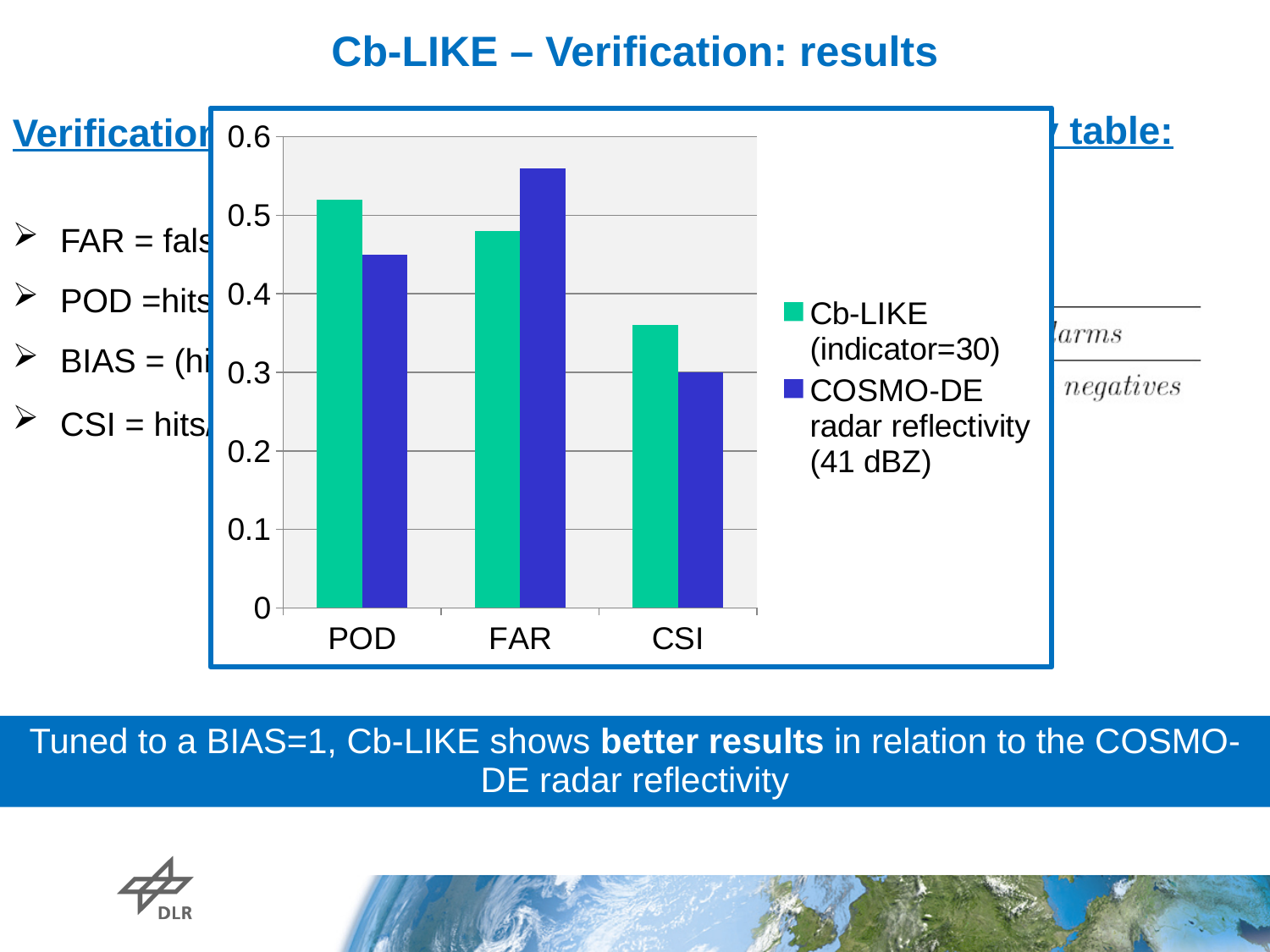
Is the FAR value for COSMO-DE radar reflectivity (41 dBZ) greater or less than 0.5? greater How many series does the chart's legend list? 2 Which series has the larger CSI value, Cb-LIKE (indicator=30) or COSMO-DE radar reflectivity (41 dBZ)? Cb-LIKE (indicator=30) How many categories are shown on the x axis of the chart? 3 Is the CSI value for Cb-LIKE (indicator=30) greater or less than 0.4? less Is the POD value for COSMO-DE radar reflectivity (41 dBZ) greater or less than 0.5? less What kind of chart is shown on the slide? bar chart Which bar is the tallest in the chart? FAR for COSMO-DE radar reflectivity (41 dBZ) Which series has the larger POD value, Cb-LIKE (indicator=30) or COSMO-DE radar reflectivity (41 dBZ)? Cb-LIKE (indicator=30) Which series has the larger FAR value, Cb-LIKE (indicator=30) or COSMO-DE radar reflectivity (41 dBZ)? COSMO-DE radar reflectivity (41 dBZ) What colour represents the Cb-LIKE (indicator=30) series in the chart? green For the Cb-LIKE (indicator=30) series, which category has the lowest value? CSI